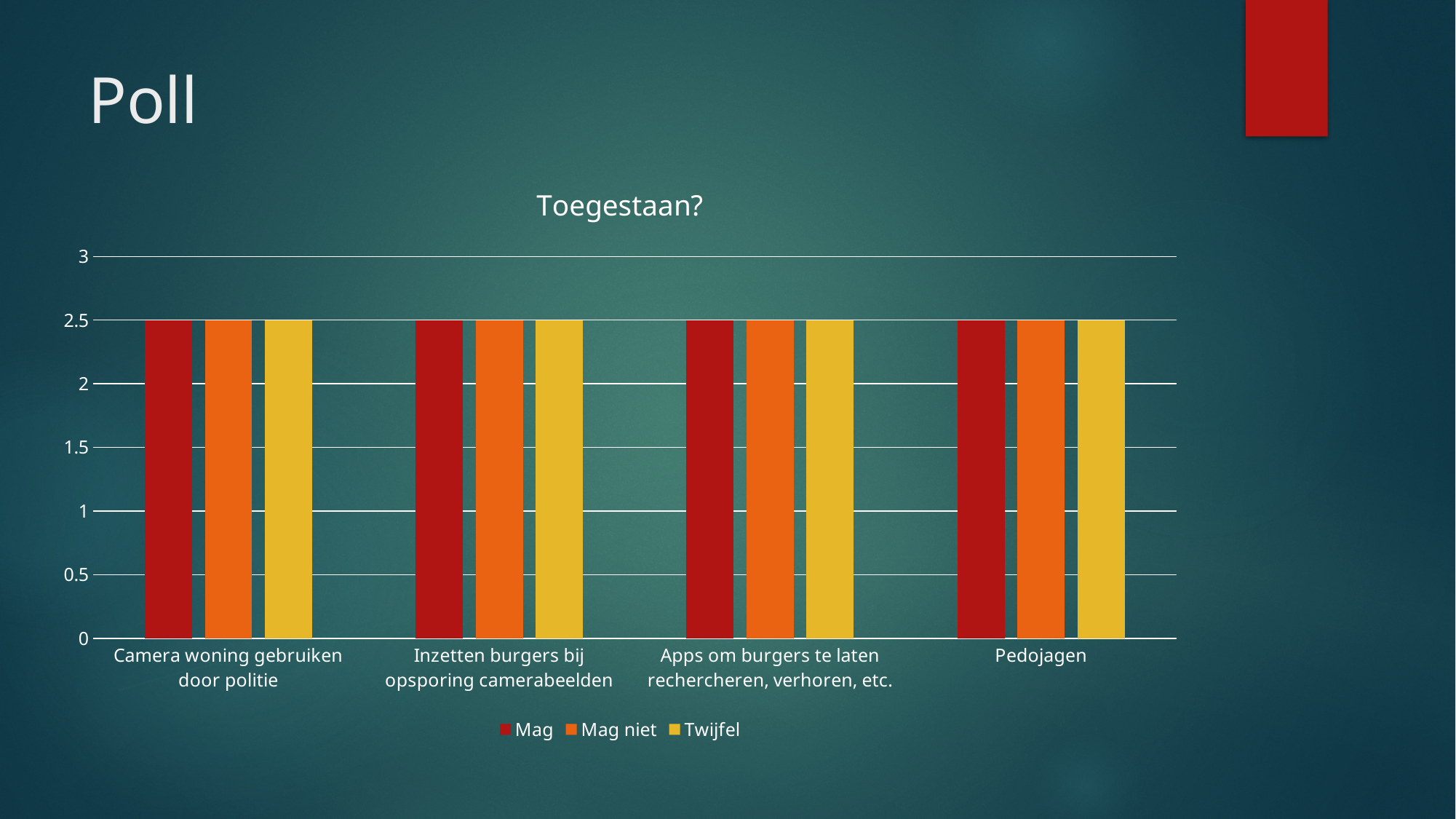
How many categories are shown on the x axis? 4 Do the values rise, fall, or stay the same across the categories along the x axis? stay the same What kind of chart is shown on the slide? bar chart What are the three series named in the legend? Mag, Mag niet, Twijfel Is the value of the Mag bar for Apps om burgers te laten rechercheren, verhoren, etc. greater or less than 2? greater Is the value of the Twijfel bar for Pedojagen greater or less than 3? less What is the value of the Mag niet bar for Inzetten burgers bij opsporing camerabeelden? 2.5 How many series does the legend list? 3 What is the difference between the Mag and Mag niet values for Pedojagen? 0 What is the title of the chart? Toegestaan? What is the value of the Twijfel bar for Camera woning gebruiken door politie? 2.5 What is the value of the Mag bar for Pedojagen? 2.5